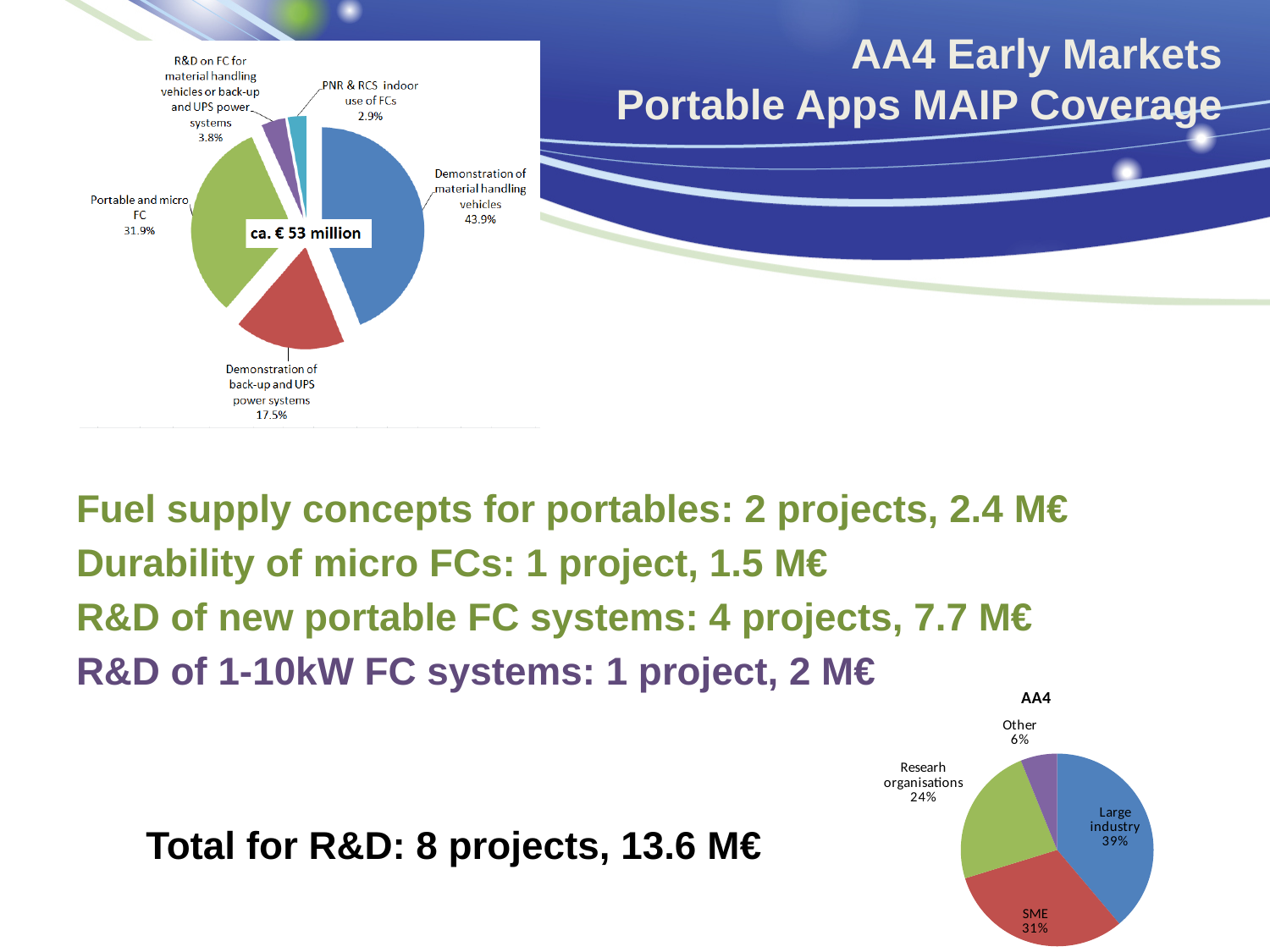
In the top-left pie chart, what share is labelled for Portable and micro FC? 31.9% What total amount is printed in the centre of the top-left pie chart? ca. € 53 million In the top-left pie chart, what share is labelled for Demonstration of material handling vehicles? 43.9% In the AA4 pie chart, which category has the smallest share? Other In the top-left pie chart, how many slices are there? 5 In the top-left pie chart, what is the difference between the shares for Demonstration of material handling vehicles and Portable and micro FC? 12.0% In the AA4 pie chart, which is larger, SME or Research organisations? SME In the AA4 pie chart, what share is labelled for Research organisations? 24% In the top-left pie chart, what share is labelled for Demonstration of back-up and UPS power systems? 17.5% In the top-left pie chart, which category has the smallest share? PNR & RCS indoor use of FCs In the top-left pie chart, which category has the largest share? Demonstration of material handling vehicles In the AA4 pie chart, what share is labelled for Large industry? 39%